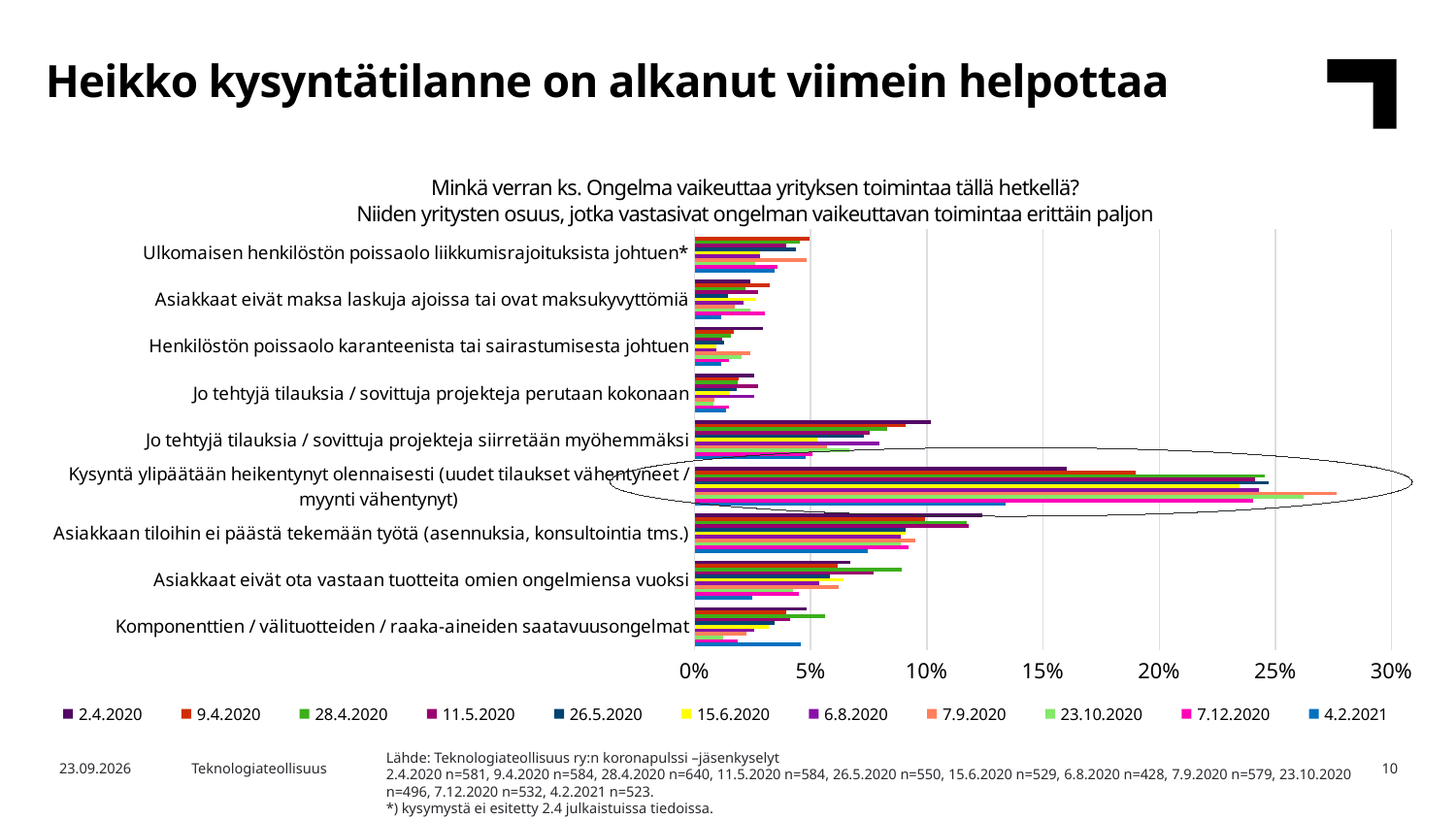
What is the highest value shown on the horizontal axis of the chart? 30% For the 9.4.2020 series, which is larger: 'Asiakkaan tiloihin ei päästä tekemään työtä' or 'Komponenttien / välituotteiden / raaka-aineiden saatavuusongelmat'? Asiakkaan tiloihin ei päästä tekemään työtä How many categories (problems) are listed on the vertical axis of the chart? 9 Which category has the longest bars in the chart? Kysyntä ylipäätään heikentynyt olennaisesti (uudet tilaukset vähentyneet / myynti vähentynyt) For 'Kysyntä ylipäätään heikentynyt olennaisesti', which is larger: the 7.9.2020 value or the 4.2.2021 value? 7.9.2020 Which series is listed first in the chart legend? 2.4.2020 Is the 4.2.2021 value for 'Kysyntä ylipäätään heikentynyt olennaisesti' greater or less than 15%? less Are all the values for 'Henkilöstön poissaolo karanteenista tai sairastumisesta johtuen' greater or less than 5%? less What kind of chart is shown on the slide? bar chart Is the 7.9.2020 value for 'Kysyntä ylipäätään heikentynyt olennaisesti' greater or less than 25%? greater How many series does the chart legend list? 11